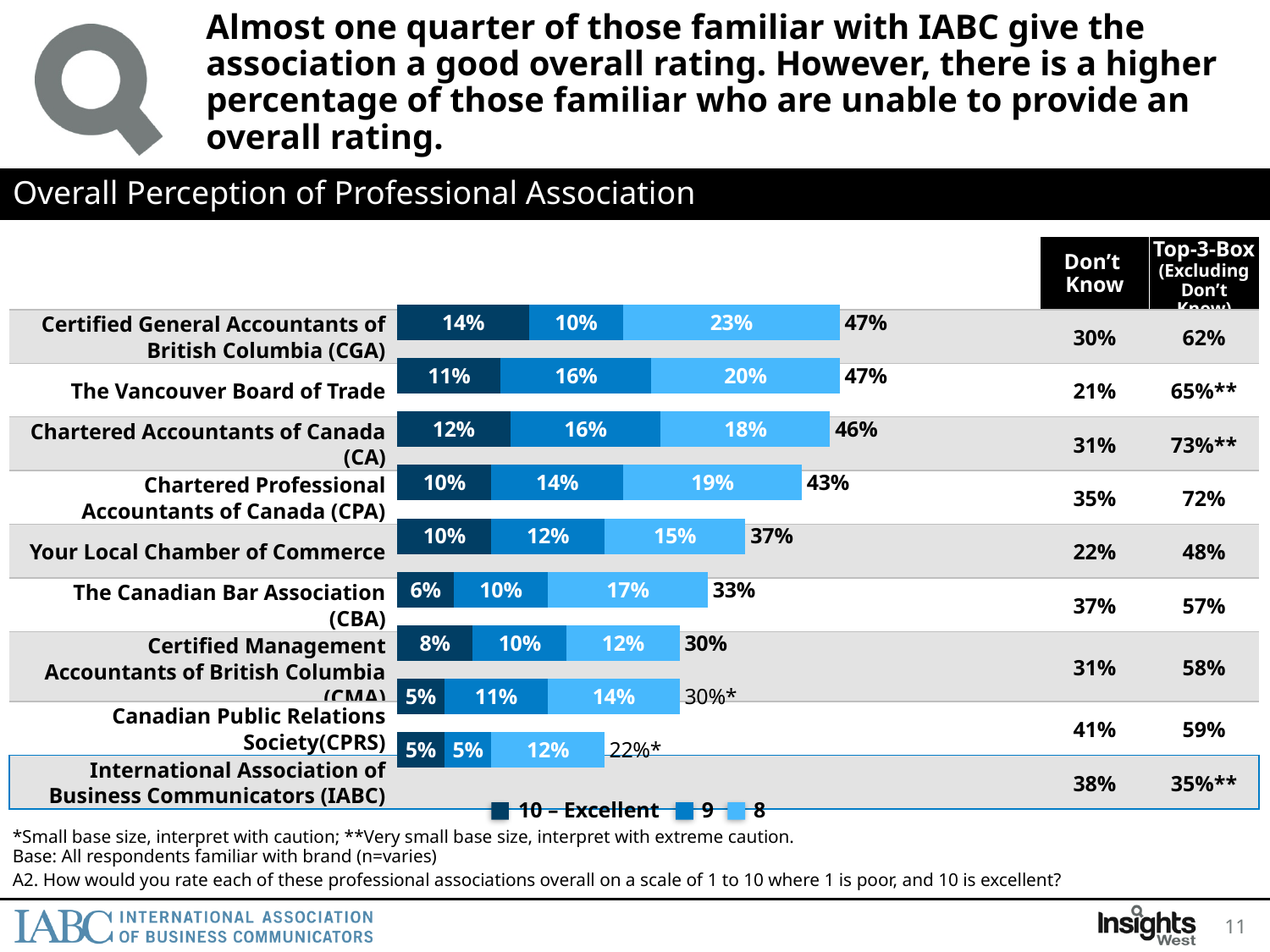
What is the total printed at the end of the stacked bar for International Association of Business Communicators (IABC)? 22%* How many series does the chart legend list? 3 What are the three entries in the chart legend? 10 – Excellent, 9, 8 Which has a larger '8' rating segment: The Canadian Bar Association (CBA) or Certified Management Accountants of British Columbia (CMA)? The Canadian Bar Association (CBA) What type of chart is used to show the overall perception of professional associations? Stacked bar chart Which association has the lowest total (top-3-box) stacked bar value? International Association of Business Communicators (IABC) What percentage of respondents gave Certified General Accountants of British Columbia (CGA) a rating of 10 – Excellent? 14% What is the value of the '8' segment for Chartered Professional Accountants of Canada (CPA)? 19% How many professional associations are shown in the chart? 9 What is the value of the '9' segment for The Vancouver Board of Trade? 16% What is the difference between the total for Certified General Accountants of British Columbia (CGA) and the total for International Association of Business Communicators (IABC)? 25 percentage points Which association has the highest value for the '8' rating segment? Certified General Accountants of British Columbia (CGA)